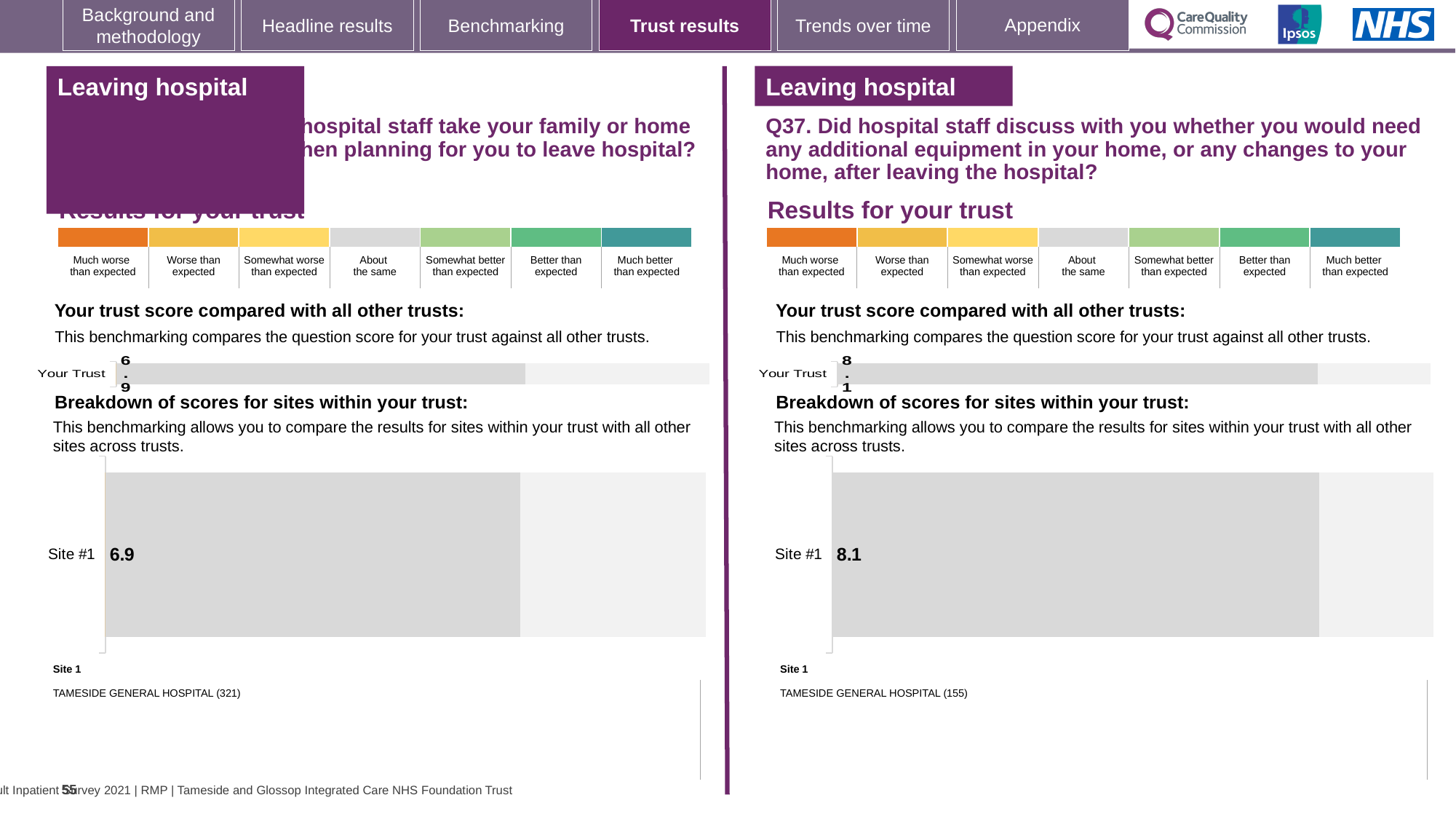
On the right half of the slide (Q37), what is the 'Your Trust' score in the trust score comparison chart? 8.1 What is the difference between the Site #1 score on the right half of the slide (Q37) and the Site #1 score on the left half? 1.2 On the left half of the slide, what is the score shown for Site #1 in the breakdown of scores for sites within your trust? 6.9 What is the name of Site 1 listed below the breakdown chart on the right half of the slide (Q37)? TAMESIDE GENERAL HOSPITAL (155) How many sites are shown in the breakdown of scores chart on the left half of the slide? 1 Which Site #1 score is larger: the one on the left half of the slide or the one on the right half (Q37)? The right half (Q37), 8.1 On the left half of the slide, what is the 'Your Trust' score in the trust score comparison chart? 6.9 What kind of chart is used to show the Site #1 score on the right half of the slide (Q37)? Bar chart What is the name of Site 1 listed below the breakdown chart on the left half of the slide? TAMESIDE GENERAL HOSPITAL (321) On the right half of the slide (Q37), what is the score shown for Site #1 in the breakdown of scores for sites within your trust? 8.1 How many sites are shown in the breakdown of scores chart on the right half of the slide (Q37)? 1